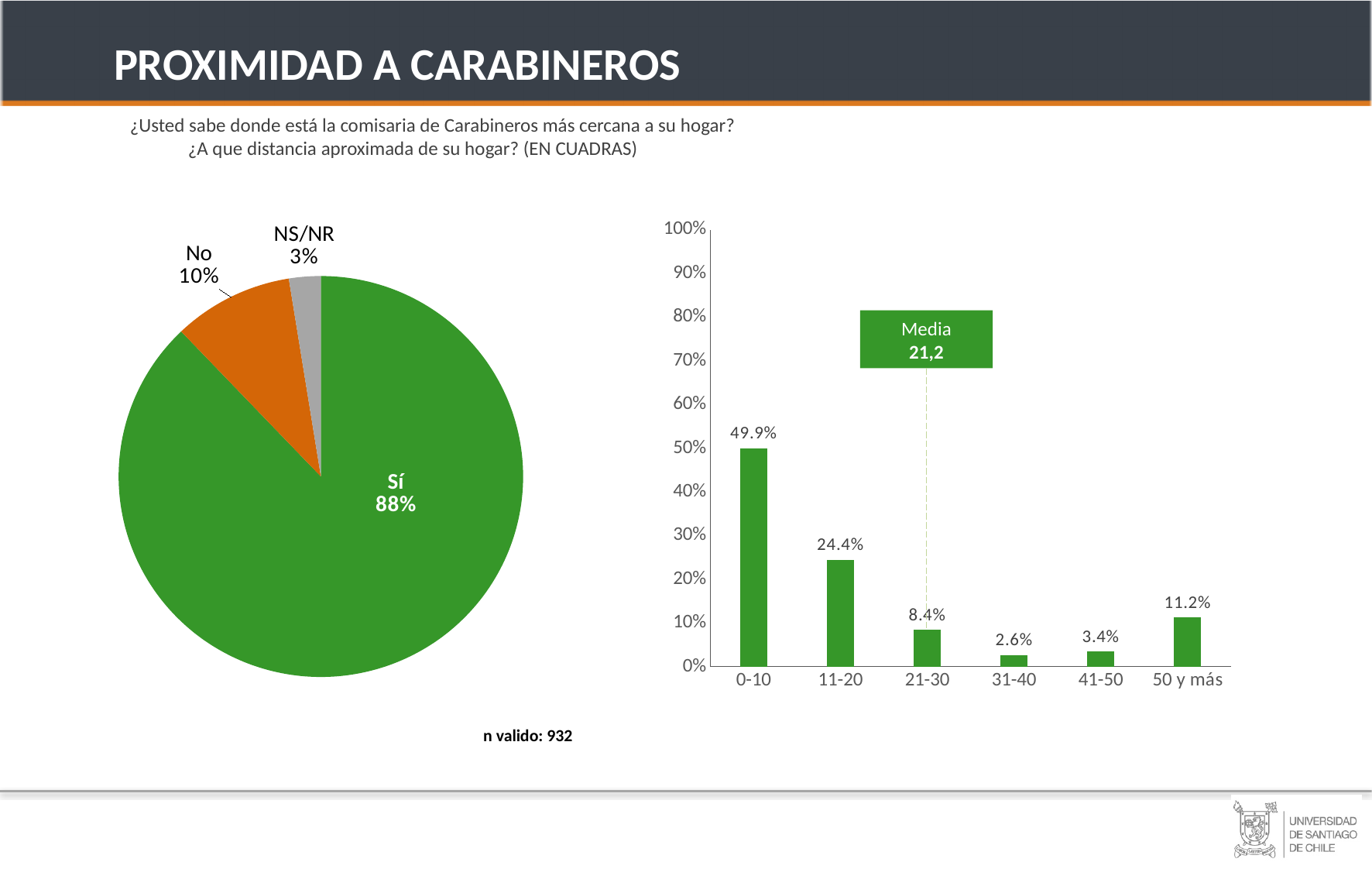
In the bar chart on the right, what is the difference between the values for 0-10 and 11-20? 25.5% In the bar chart on the right, which is larger, the value for 21-30 or the value for 50 y más? 50 y más In the bar chart on the right, which category has the lowest value? 31-40 In the pie chart on the left, which category has the smallest slice? NS/NR In the bar chart on the right, what value is shown in the "Media" box? 21,2 In the pie chart on the left, what percentage is shown for "NS/NR"? 3% In the pie chart on the left, what percentage is shown for "No"? 10% In the bar chart on the right, which category has the highest value? 0-10 In the bar chart on the right, what is the value for the 50 y más category? 11.2% In the pie chart on the left, how many slices are there? 3 In the bar chart on the right, what is the value for the 0-10 category? 49.9% In the pie chart on the left, what share of respondents answered "Sí"? 88%